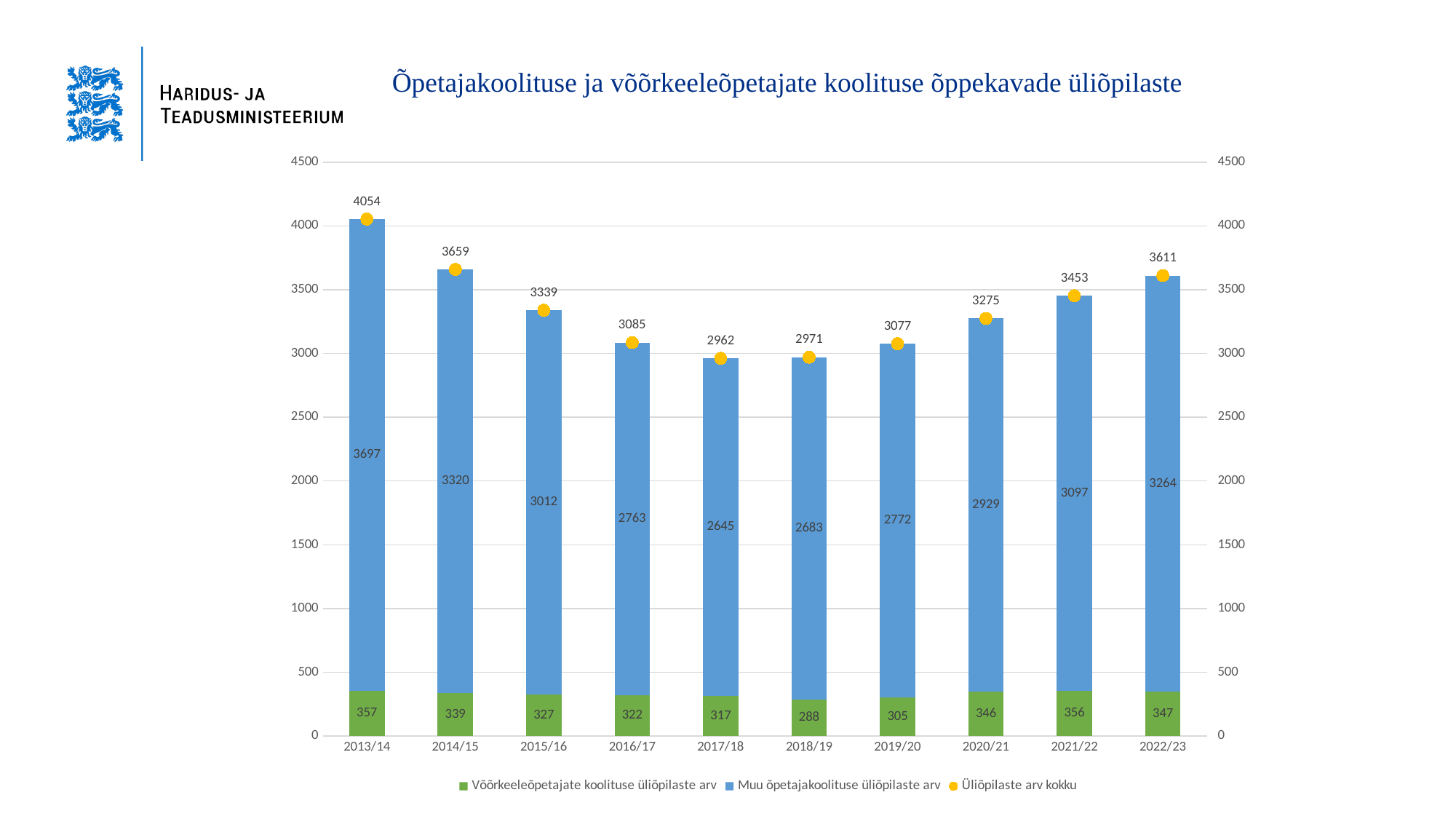
Which academic year has the highest Üliõpilaste arv kokku? 2013/14 What is the difference between the Üliõpilaste arv kokku for 2013/14 and 2014/15? 395 What is the value of Muu õpetajakoolituse üliõpilaste arv for 2013/14? 3697 What is the total of the stacked bar for 2018/19? 2971 Is the Üliõpilaste arv kokku for 2017/18 greater or less than 3000? less What is the Üliõpilaste arv kokku value for 2022/23? 3611 How many series does the legend list? 3 How many academic years are shown on the x axis? 10 Which is larger: Muu õpetajakoolituse üliõpilaste arv in 2021/22 or in 2022/23? 2022/23 Which academic year has the lowest Võõrkeeleõpetajate koolituse üliõpilaste arv? 2018/19 What kind of chart is shown on the slide? stacked bar chart What is the value of Võõrkeeleõpetajate koolituse üliõpilaste arv for 2018/19? 288